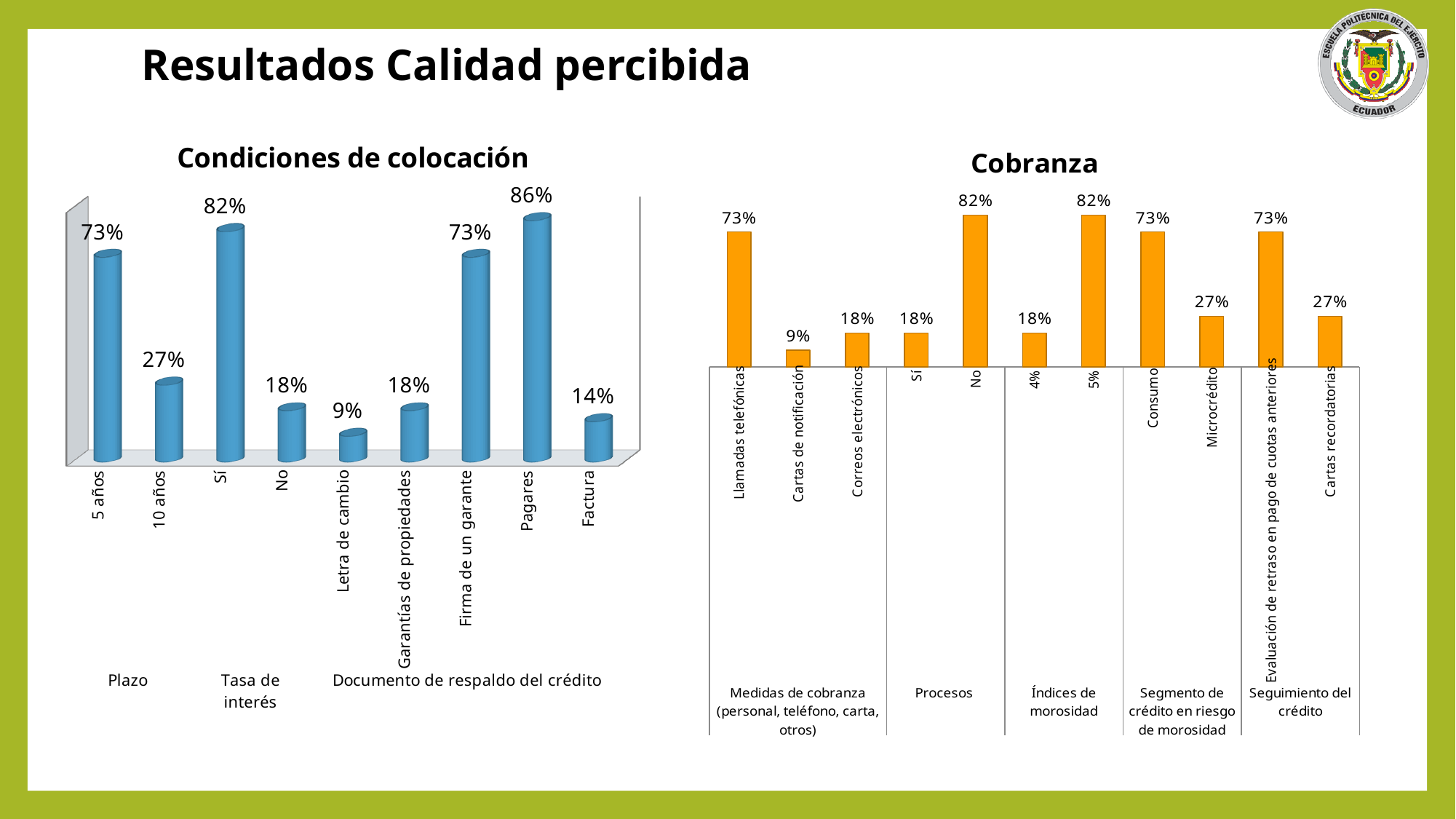
In the 'Condiciones de colocación' chart, what is the difference between the values for Sí and No? 64% In the 'Condiciones de colocación' chart, which category has the highest value? Pagares In the 'Cobranza' chart, how many categories are plotted? 11 In the 'Cobranza' chart, what is the value for Llamadas telefónicas? 73% In the 'Condiciones de colocación' chart, how many categories are plotted? 9 What type of chart is the 'Cobranza' chart? Bar chart In the 'Cobranza' chart, what is the value for Microcrédito? 27% In the 'Condiciones de colocación' chart, which category has the lowest value? Letra de cambio In the 'Cobranza' chart, which category has the lowest value? Cartas de notificación In the 'Condiciones de colocación' chart, what is the value for 10 años? 27% In the 'Condiciones de colocación' chart, what is the value for Pagares? 86% In the 'Cobranza' chart, which is larger, the value for Consumo or the value for Microcrédito? Consumo